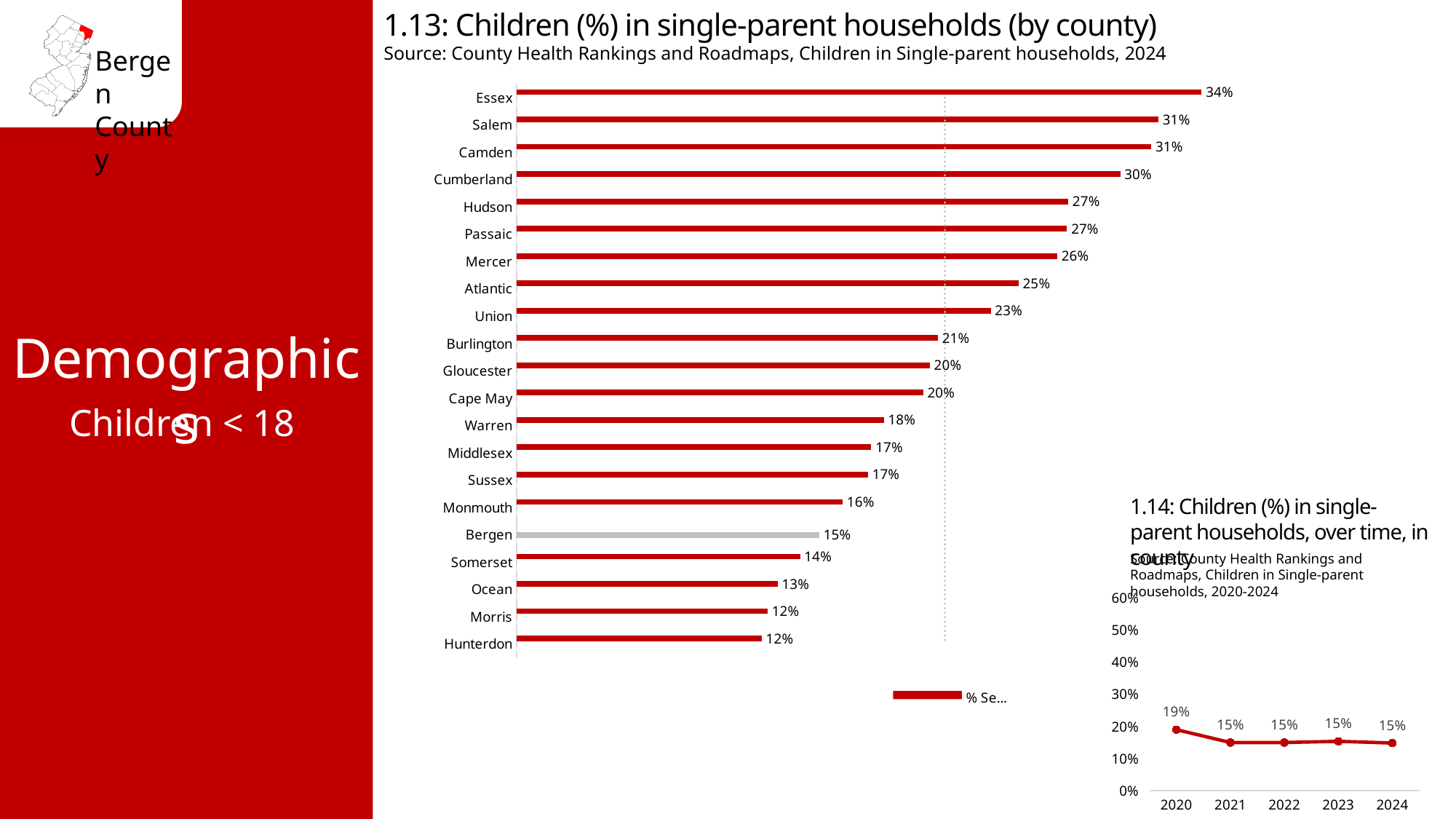
In chart 1.13 (by county), which is larger, the value for Camden or the value for Union? Camden In chart 1.13 (by county), how many counties are shown? 21 In chart 1.13 (Children (%) in single-parent households by county), what is the value for Bergen? 15% In chart 1.13 (by county), what is the value for Cumberland? 30% In chart 1.14 (over time), do the values rise or fall from 2020 to 2021? Fall In chart 1.13 (by county), what is the value for Hudson? 27% What kind of chart is chart 1.14 (Children (%) in single-parent households over time)? Line chart In chart 1.13 (by county), which county has the highest percentage of children in single-parent households? Essex What kind of chart is chart 1.13 (Children (%) in single-parent households by county)? Bar chart In chart 1.14 (over time), what is the value for 2024? 15% In chart 1.13 (by county), what is the difference between Essex and Bergen? 19 percentage points In chart 1.14 (Children (%) in single-parent households over time), what is the value for 2020? 19%